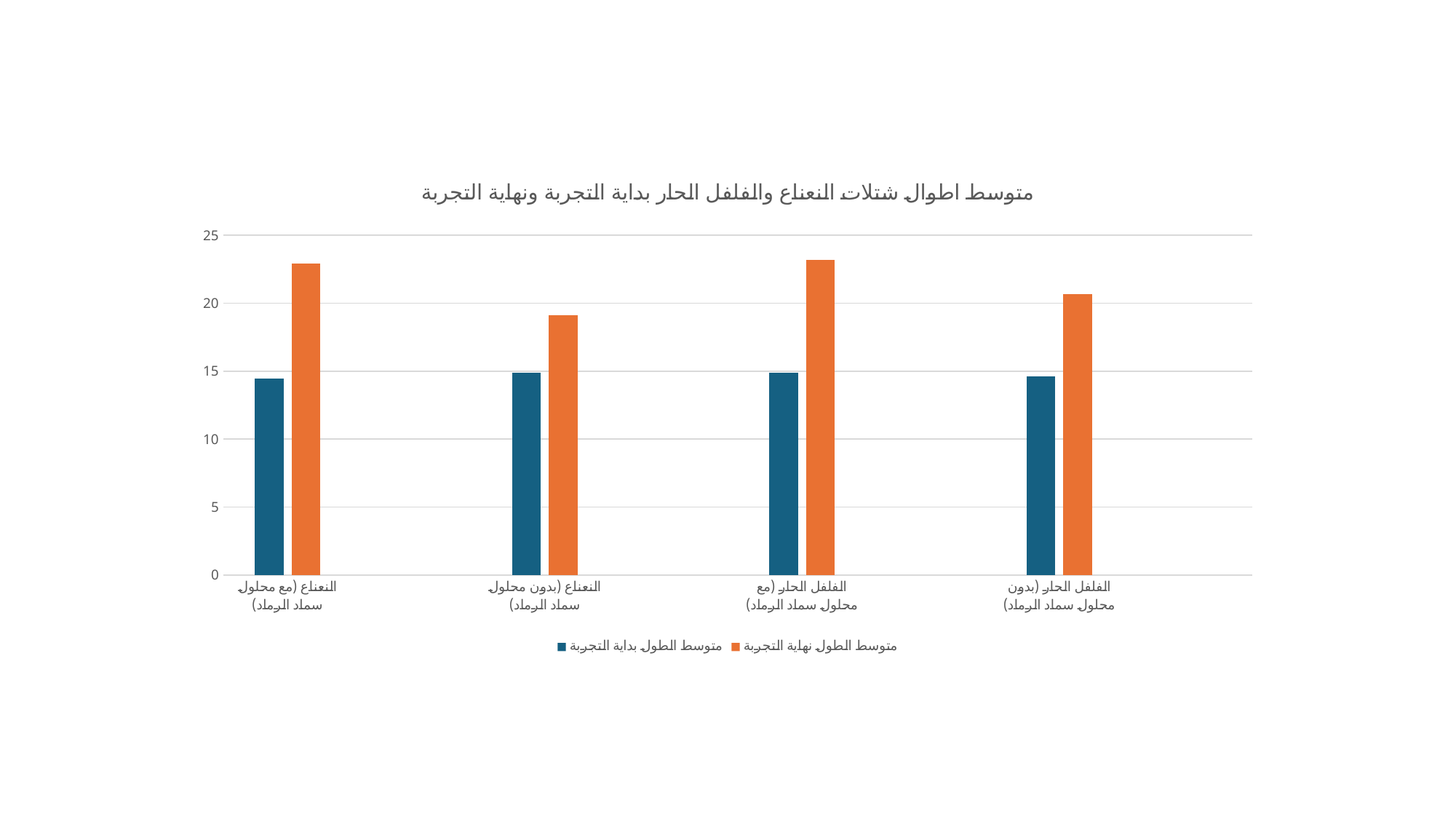
For الفلفل الحار (بدون محلول سماد الرماد), which is larger: متوسط الطول بداية التجربة or متوسط الطول نهاية التجربة? متوسط الطول نهاية التجربة Is the value of متوسط الطول نهاية التجربة for النعناع (مع محلول سماد الرماد) greater or less than 20? greater Which series is shown in orange? متوسط الطول نهاية التجربة How many series does the legend list? 2 How many categories are shown on the x axis? 4 Among the categories, which has the lowest value for متوسط الطول نهاية التجربة? النعناع (بدون محلول سماد الرماد) For متوسط الطول نهاية التجربة, which is larger: النعناع (بدون محلول سماد الرماد) or الفلفل الحار (بدون محلول سماد الرماد)? الفلفل الحار (بدون محلول سماد الرماد) Is the value of متوسط الطول نهاية التجربة for الفلفل الحار (مع محلول سماد الرماد) greater or less than 20? greater Is the value of متوسط الطول نهاية التجربة for النعناع (بدون محلول سماد الرماد) greater or less than 20? less What is the title of the chart? متوسط اطوال شتلات النعناع والفلفل الحار بداية التجربة ونهاية التجربة What kind of chart is shown on the slide? bar chart